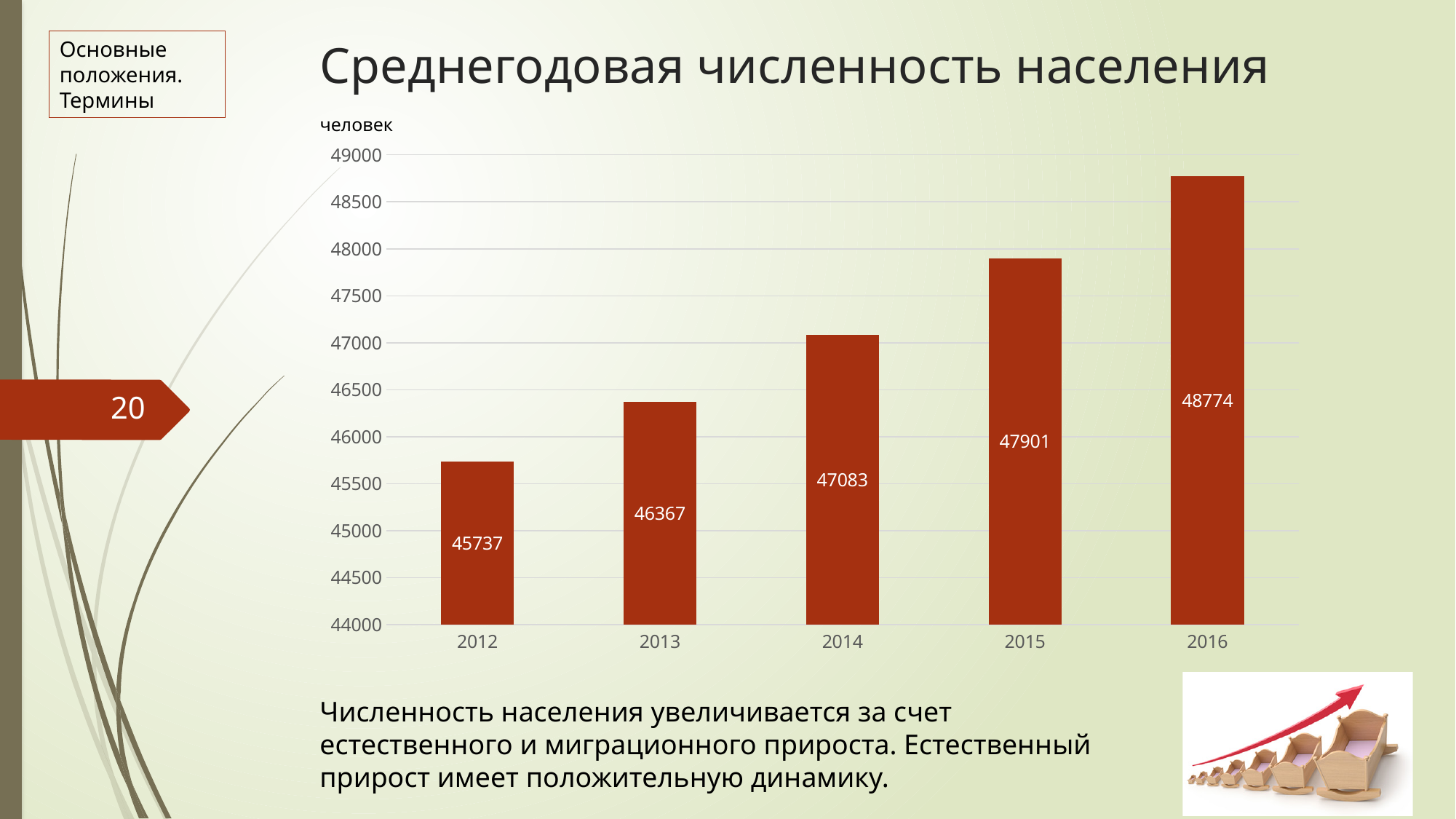
Which year has the lowest average annual population? 2012 What is the average annual population for 2014? 47083 Which year has a larger population, 2013 or 2015? 2015 What is the average annual population for 2012? 45737 Which year has the highest average annual population? 2016 What is the average annual population for 2016? 48774 Do the values rise or fall from 2012 to 2016? rise How many years are shown on the chart? 5 Is the value for 2013 greater or less than 46000? greater What kind of chart is shown on the slide? bar chart What is the difference between the population in 2016 and in 2012? 3037 What is the difference between the population in 2015 and in 2014? 818